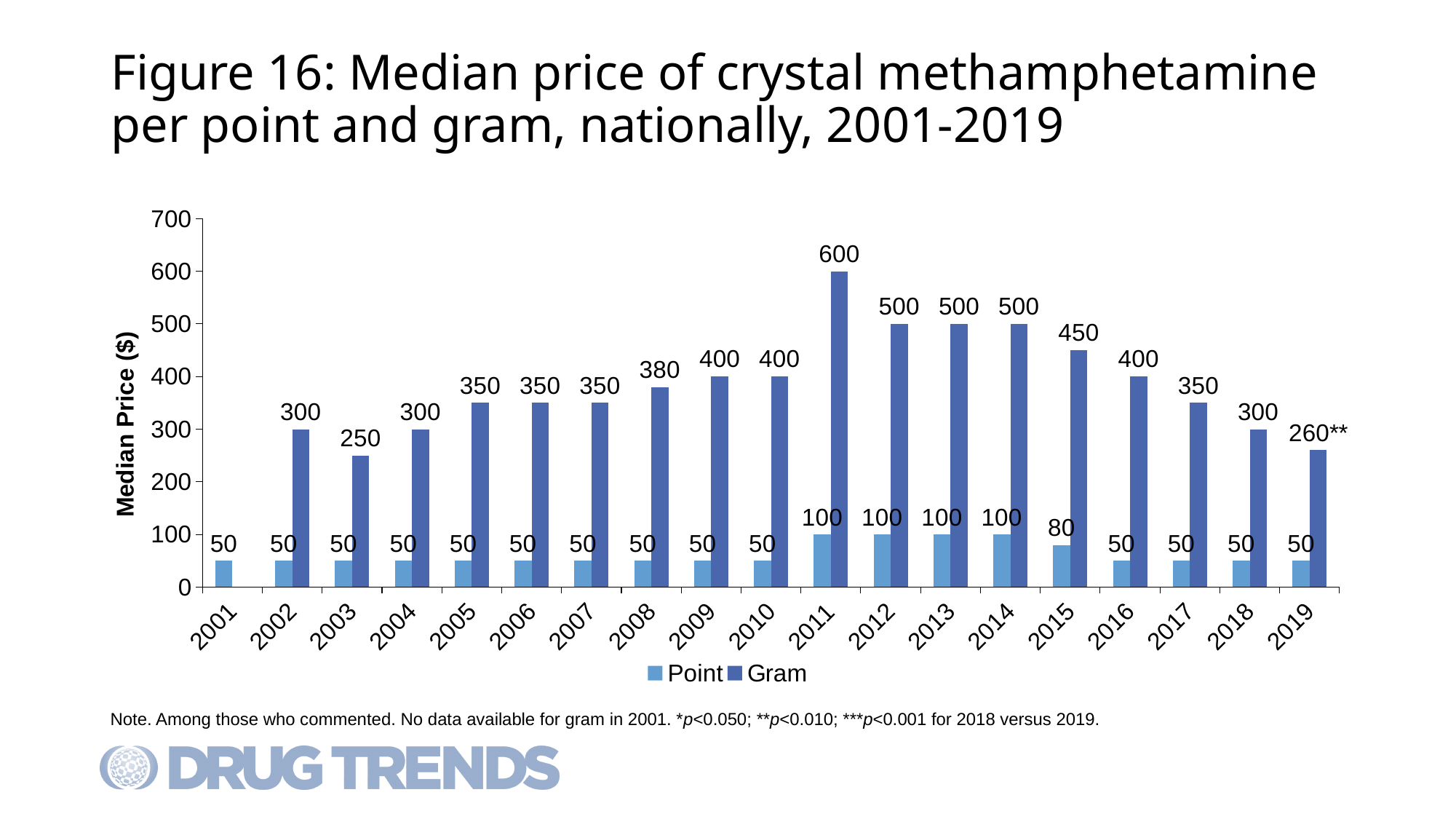
Which is larger, the median price per gram in 2015 or in 2016? 2015 What is the median price per gram in 2019? 260 In which year is the median price per gram highest? 2011 What is the label of the y axis? Median Price ($) What kind of chart is this? bar chart In which year is the median price per gram lowest? 2003 What is the median price per gram in 2011? 600 How many years are shown on the x axis? 19 What is the median price per point in 2015? 80 Does the median price per gram rise or fall from 2014 to 2019? fall What is the difference between the median price per gram in 2018 and in 2019? 40 How many series does the legend list? 2